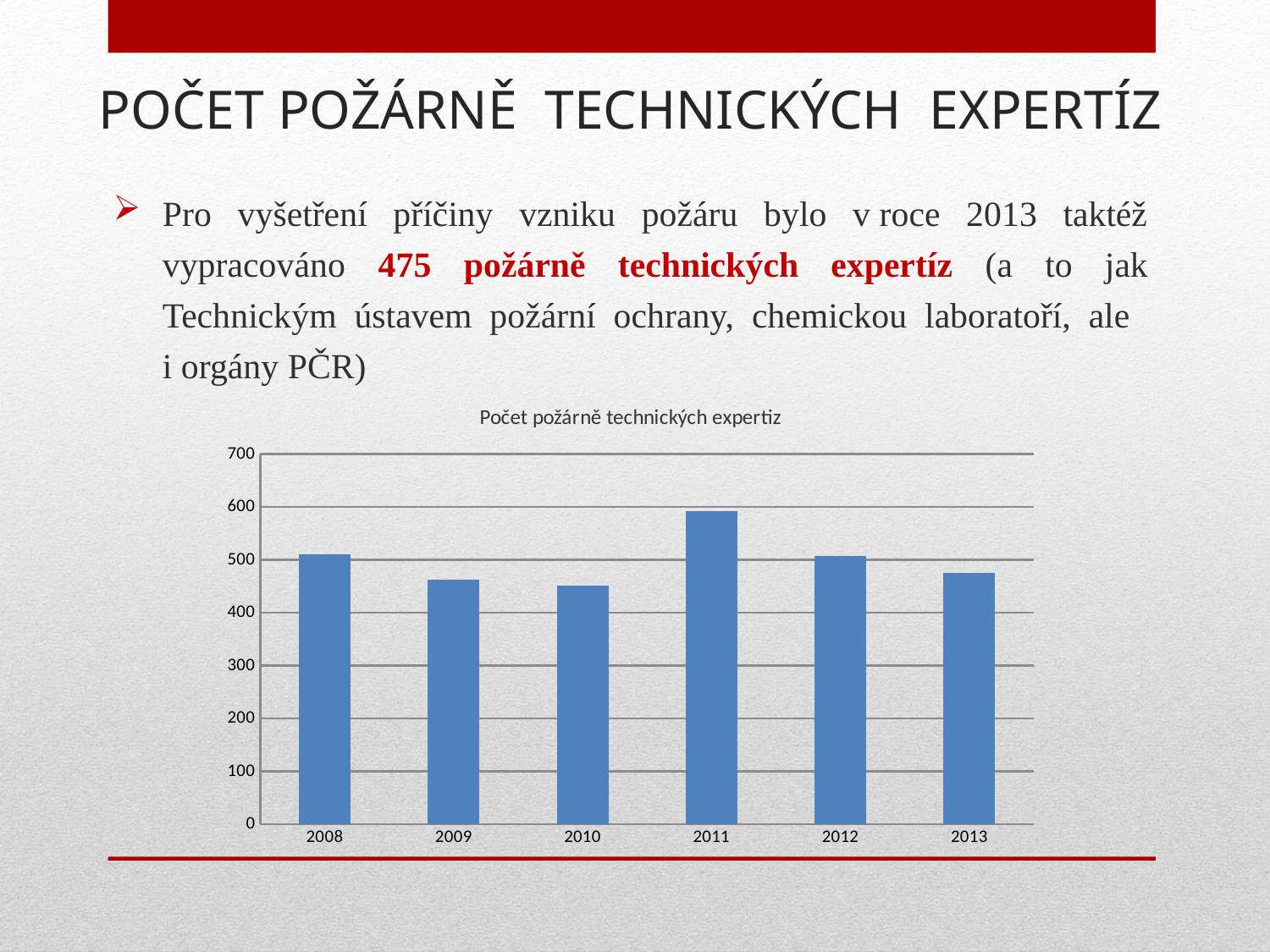
Which is larger, the value for 2008 or the value for 2010? 2008 What is the title of the chart? Počet požárně technických expertiz Is the value for 2009 greater or less than 500? less Do the values rise or fall from 2008 to 2010? fall Which is larger, the value for 2011 or the value for 2013? 2011 Is the value for 2010 greater or less than 400? greater Is the value for 2010 greater or less than 500? less How many fire technical expertises were prepared in 2013 according to the slide? 475 What type of chart is shown on the slide? bar chart Which year has the highest number of fire technical expertises in the chart? 2011 How many years are shown on the x axis of the chart? 6